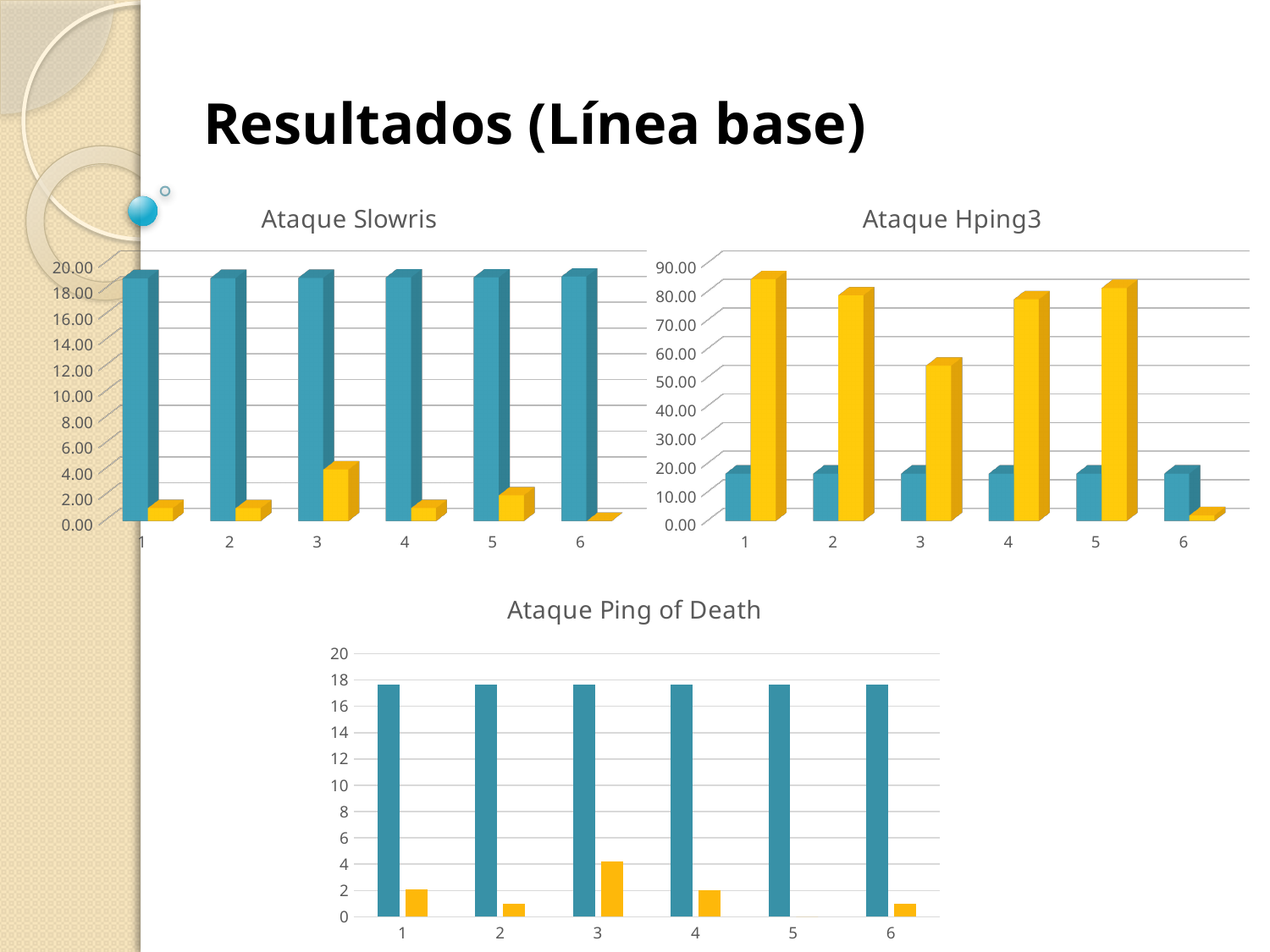
In the "Ataque Hping3" chart, which category has the shortest yellow bar? 6 In the "Ataque Hping3" chart, which is larger for category 3, the blue bar or the yellow bar? the yellow bar In the "Ataque Ping of Death" chart, which category has the tallest yellow bar? 3 How many categories are shown on the x axis of the "Ataque Hping3" chart? 6 What kind of chart is the "Ataque Slowris" chart? bar chart Do the blue bars in the "Ataque Ping of Death" chart rise, fall, or stay roughly level across categories 1 to 6? stay roughly level What is the title of the chart at the bottom of the slide? Ataque Ping of Death In the "Ataque Ping of Death" chart, is the blue bar for category 1 greater or less than 16? greater In the "Ataque Hping3" chart, is the yellow bar for category 3 greater or less than 50.00? greater In the "Ataque Slowris" chart, is the blue bar for category 1 greater or less than 18.00? greater In the "Ataque Slowris" chart, which category has the tallest yellow bar? 3 In the "Ataque Ping of Death" chart, which is larger for category 4, the blue bar or the yellow bar? the blue bar